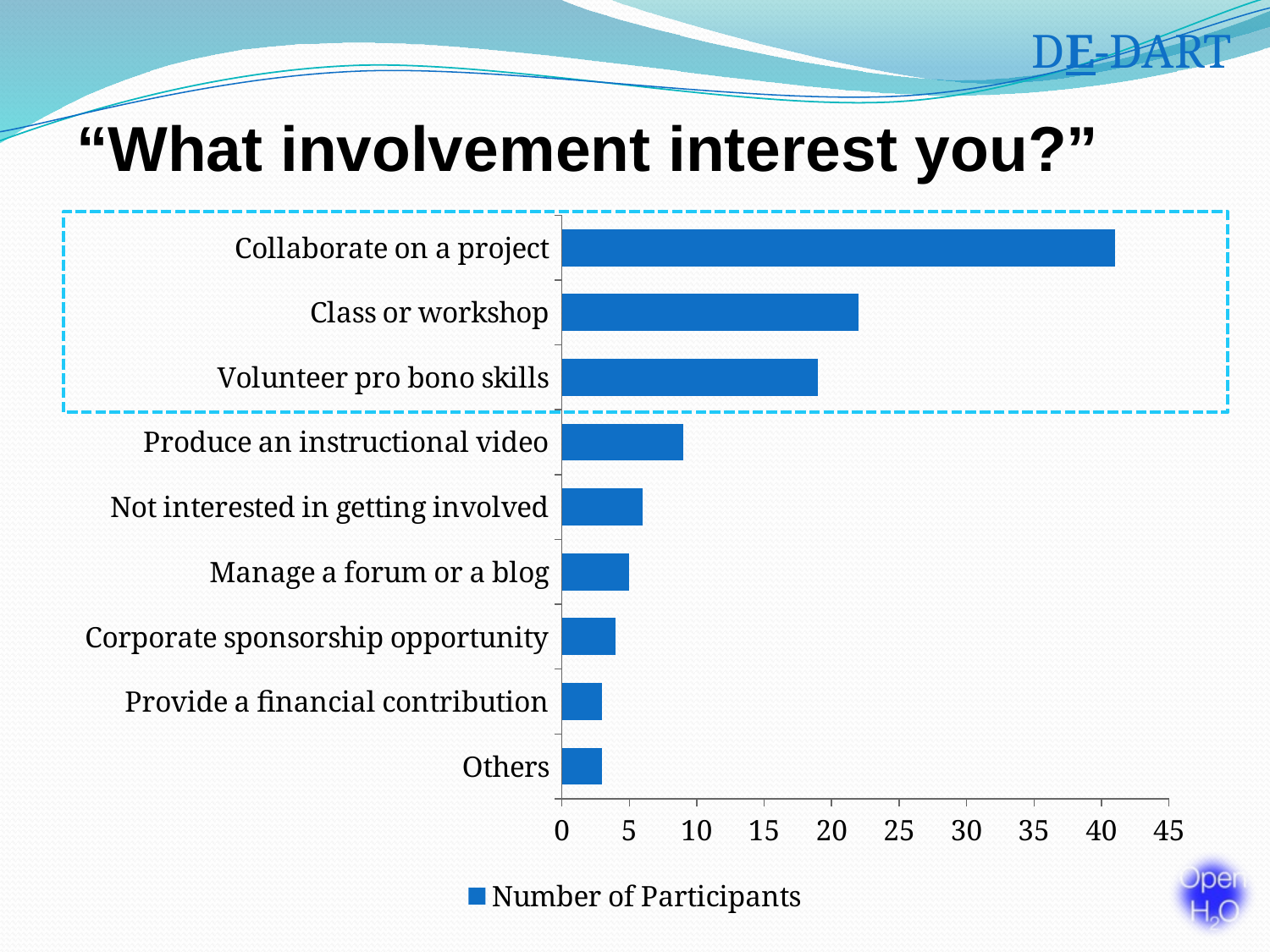
How many series does the legend list? 1 Is the value for Class or workshop greater or less than 20? greater Which has more participants, Class or workshop or Volunteer pro bono skills? Class or workshop Is the value for Volunteer pro bono skills greater or less than 15? greater Which category has the highest number of participants? Collaborate on a project What kind of chart is shown on the slide? Bar chart Is the value for Collaborate on a project greater or less than 35? greater What is the legend entry for the series shown on the chart? Number of Participants How many categories are plotted on the chart? 9 Which has more participants, Produce an instructional video or Not interested in getting involved? Produce an instructional video